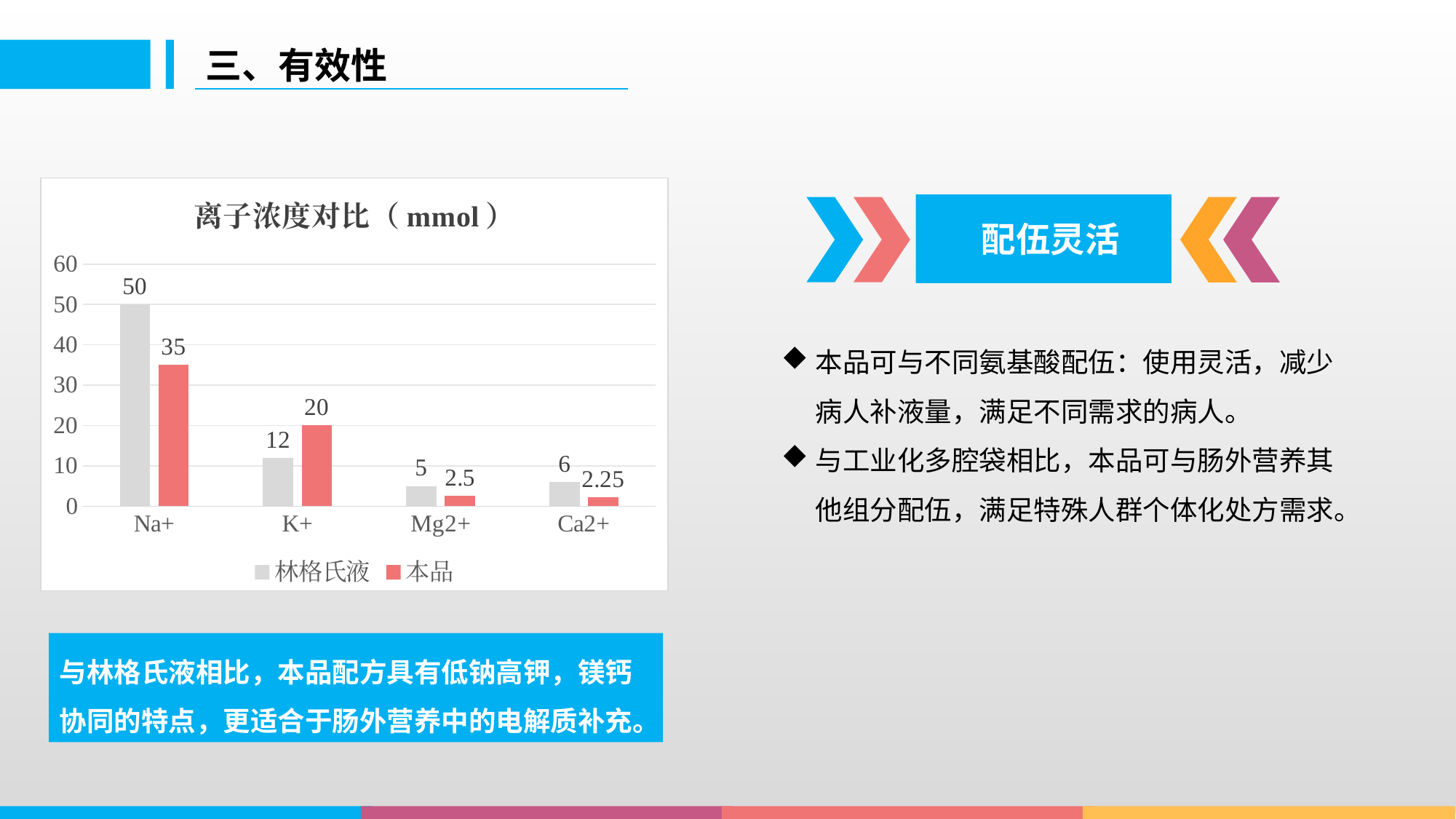
Which category has the lowest value for 本品? Ca2+ How many categories are shown on the x axis? 4 What is the title of the chart? 离子浓度对比（mmol） What is the value for 林格氏液 at Na+? 50 What is the value for 林格氏液 at Ca2+? 6 Which category has the highest value for 林格氏液? Na+ How many series does the legend list? 2 What is the value for 本品 at K+? 20 What is the difference between 林格氏液 and 本品 at Na+? 15 What kind of chart is shown? bar chart What is the value for 本品 at Mg2+? 2.5 Which is larger at K+, 林格氏液 or 本品? 本品